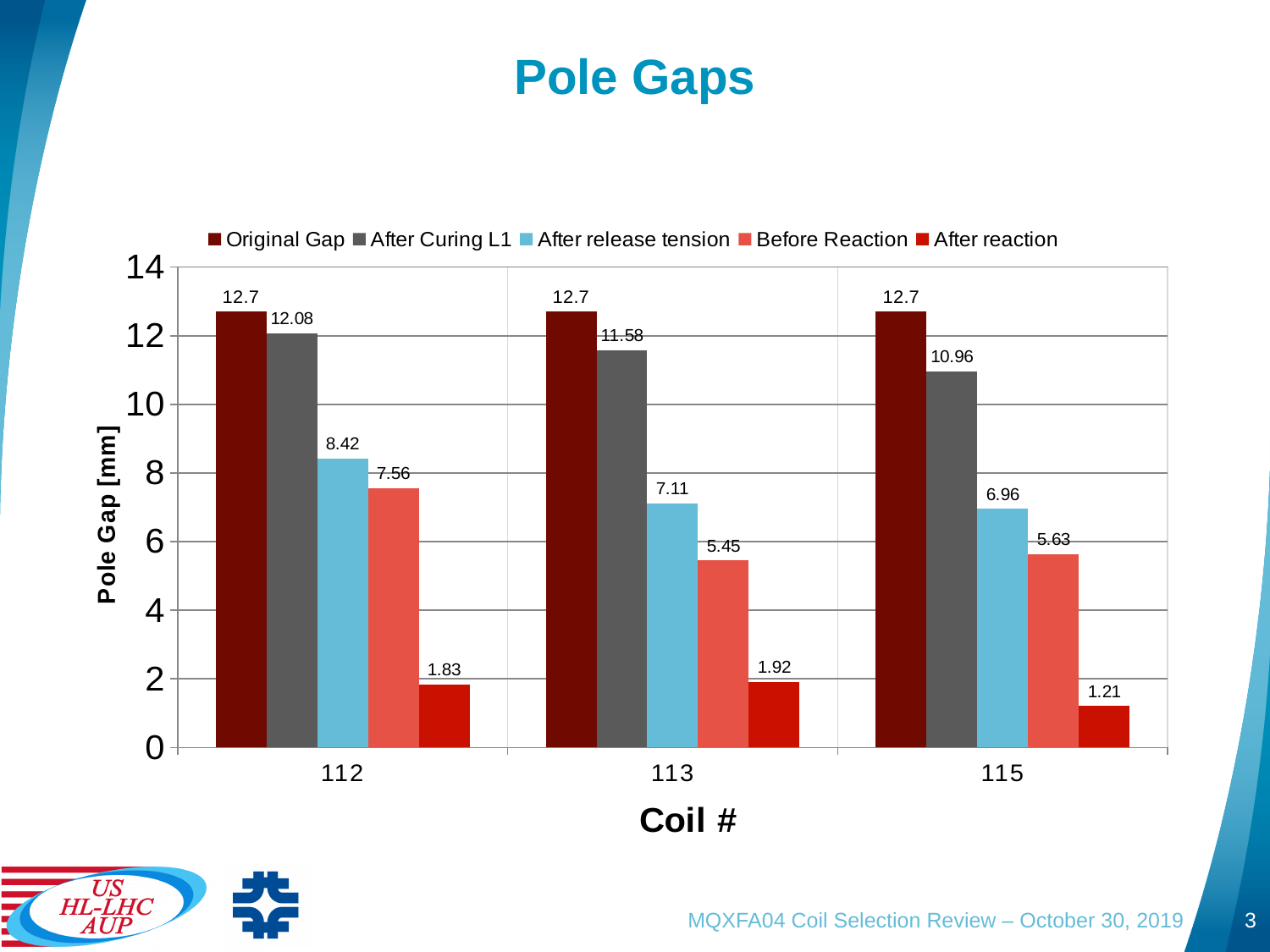
What is the After Curing L1 value for coil 113? 11.58 What is the y-axis label? Pole Gap [mm] Which coil has the highest After release tension value? 112 What is the Before Reaction value for coil 112? 7.56 Which coil has the lowest After reaction value? 115 How many coils are shown on the x axis? 3 How many series does the legend list? 5 Which is larger, the Before Reaction value for coil 113 or for coil 115? coil 115 What kind of chart is shown? bar chart What is the difference between the Original Gap and the After Curing L1 value for coil 115? 1.74 What is the After reaction value for coil 115? 1.21 What is the difference between the After release tension and Before Reaction values for coil 113? 1.66